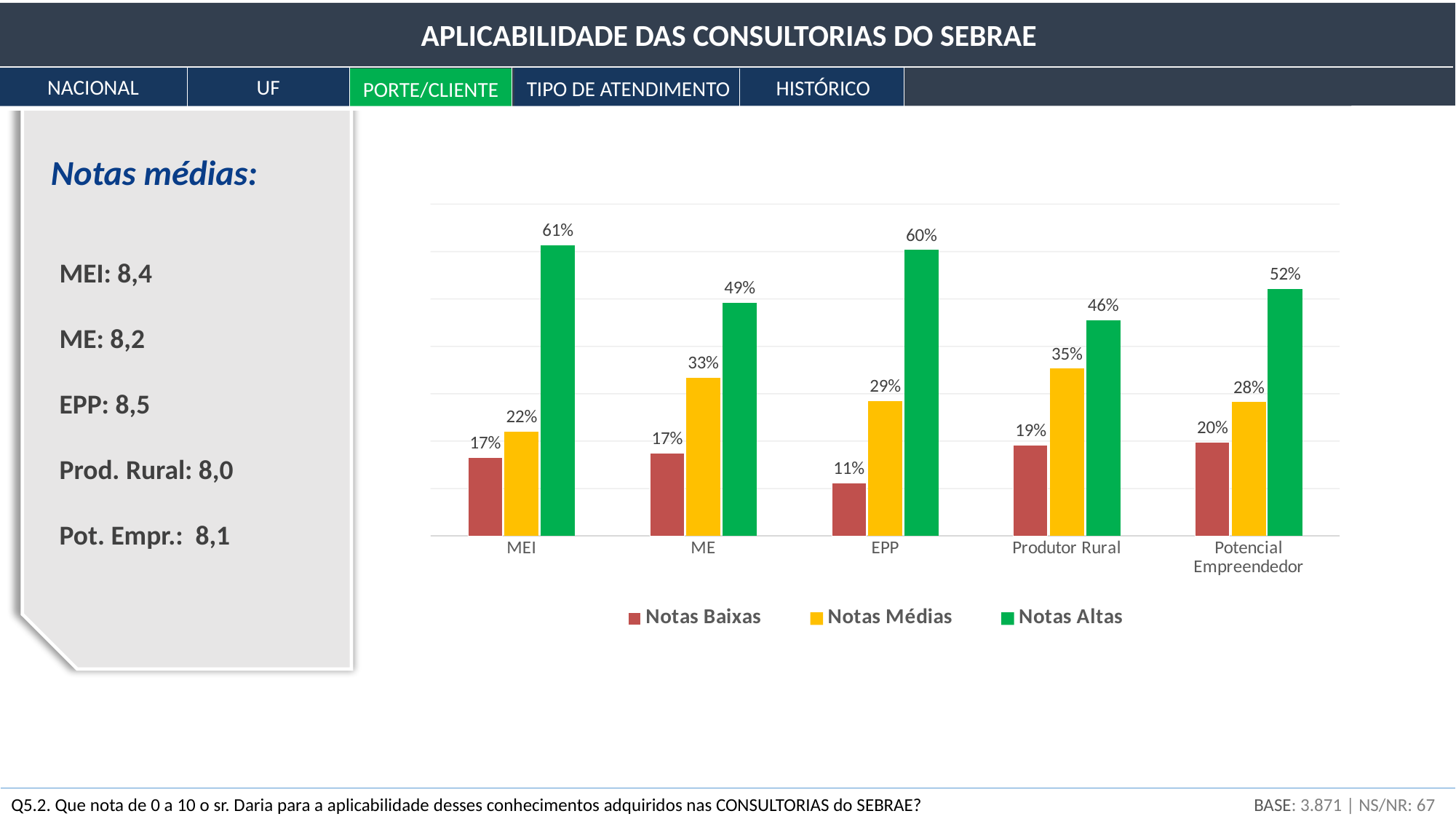
What kind of chart is shown? Bar chart How many series does the legend list? 3 What colour represents the Notas Altas series? Green What is the value of Notas Altas for MEI? 61% Which category has the lowest Notas Baixas value? EPP What is the total of Notas Baixas, Notas Médias and Notas Altas for Potencial Empreendedor? 100% What is the value of Notas Baixas for EPP? 11% What is the value of Notas Médias for Produtor Rural? 35% Which is larger: Notas Médias for ME or Notas Médias for EPP? Notas Médias for ME Which category has the highest Notas Altas value? MEI How many categories are shown on the x axis? 5 What is the difference between Notas Altas for MEI and Notas Altas for Potencial Empreendedor? 9%